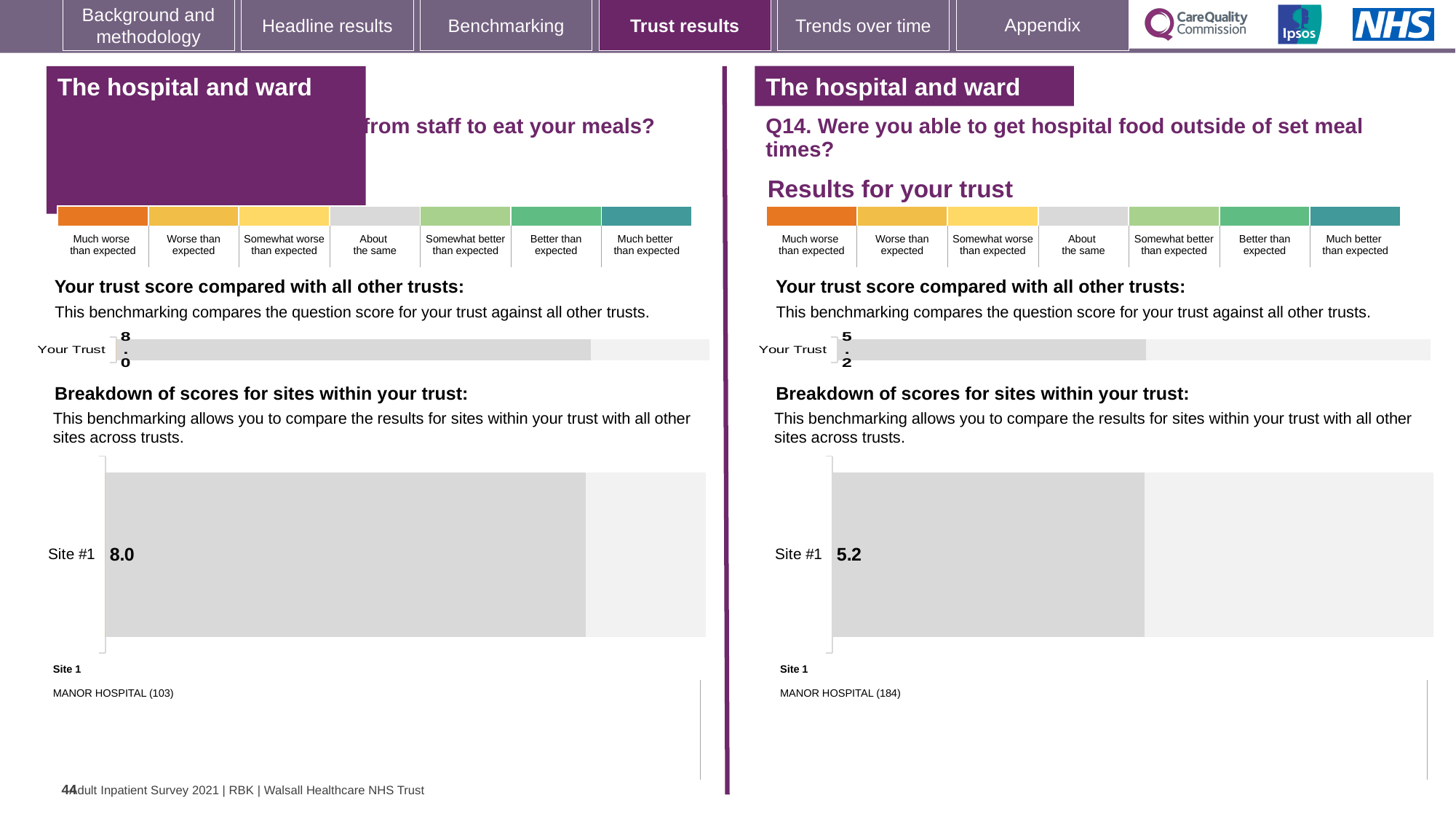
Which site name is listed as Site 1 below the left-hand breakdown chart? MANOR HOSPITAL (103) How many sites are shown in the right-hand Q14 site breakdown chart? 1 What is the difference between the Your Trust score on the left-hand chart and the Your Trust score on the right-hand Q14 chart? 2.8 On the right-hand chart for Q14 (hospital food outside of set meal times), what is the score shown for Your Trust? 5.2 Which site name is listed as Site 1 below the right-hand Q14 breakdown chart? MANOR HOSPITAL (184) On the left-hand chart (question about help from staff to eat your meals), what is the score shown for Your Trust? 8.0 On the left-hand site breakdown chart, what is the score for Site #1? 8.0 On the right-hand Q14 chart, is the Your Trust score equal to the Site #1 score? Yes, both are 5.2 Which is larger: the Site #1 score on the left-hand breakdown chart or the Site #1 score on the right-hand Q14 breakdown chart? Left-hand chart (8.0) On the right-hand site breakdown chart for Q14, what is the score for Site #1? 5.2 What type of chart is used to show the Site #1 score on the right-hand Q14 breakdown? Bar chart How many sites are shown in the left-hand site breakdown chart? 1